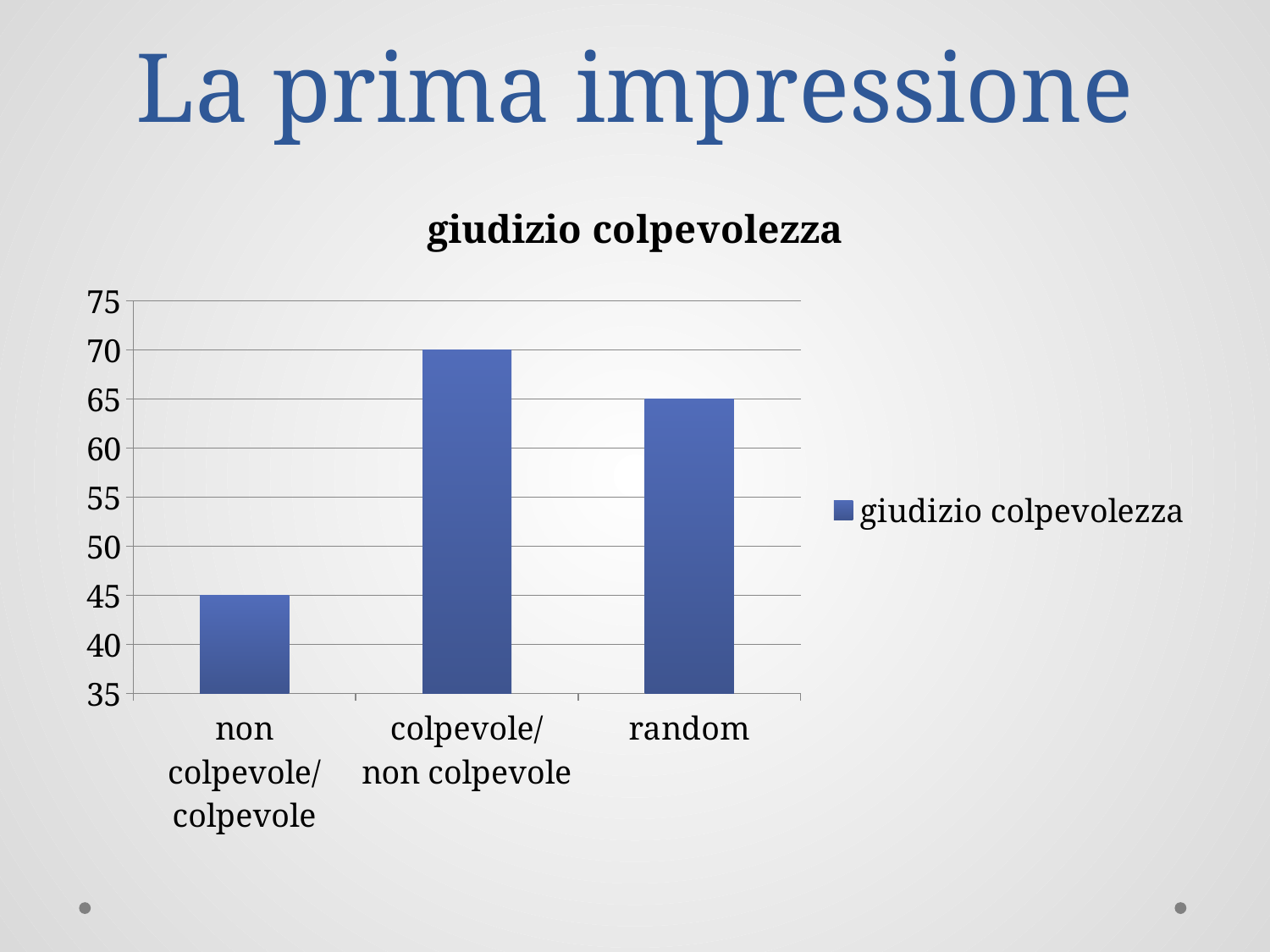
Is the value for "random" greater or less than 60? greater What is the difference between the values for "colpevole/non colpevole" and "non colpevole/colpevole"? 25 How many series does the legend list? 1 What is the value for "colpevole/non colpevole"? 70 What is the title of the chart? giudizio colpevolezza What is the value for "non colpevole/colpevole"? 45 How many categories are shown on the x axis? 3 Which is larger, the value for "random" or the value for "colpevole/non colpevole"? colpevole/non colpevole What kind of chart is shown on the slide? bar chart What is the value for "random" in the giudizio colpevolezza chart? 65 Which category has the highest value? colpevole/non colpevole Which category has the lowest value? non colpevole/colpevole